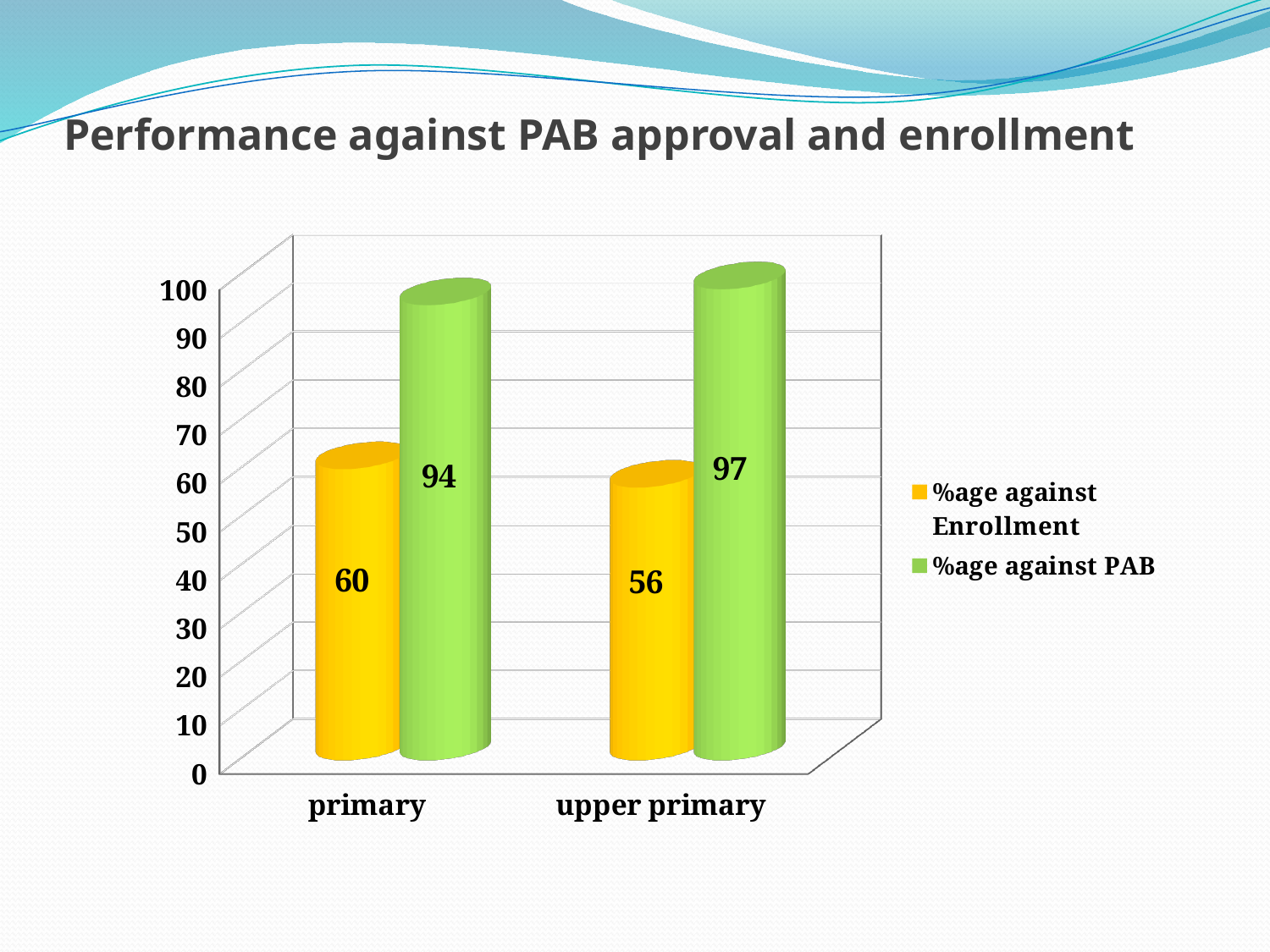
How many series does the legend list? 2 How many categories are shown on the x axis? 2 What is the %age against PAB for upper primary? 97 What is the difference between the %age against PAB and the %age against Enrollment for primary? 34 What is the %age against Enrollment for upper primary? 56 Is the %age against Enrollment for primary larger or smaller than the %age against Enrollment for upper primary? larger What is the %age against Enrollment for primary? 60 What is the difference in %age against Enrollment between primary and upper primary? 4 What type of chart is shown on the slide? bar chart Which category has the higher %age against PAB? upper primary What is the %age against PAB for primary? 94 Which category has the lower %age against Enrollment? upper primary